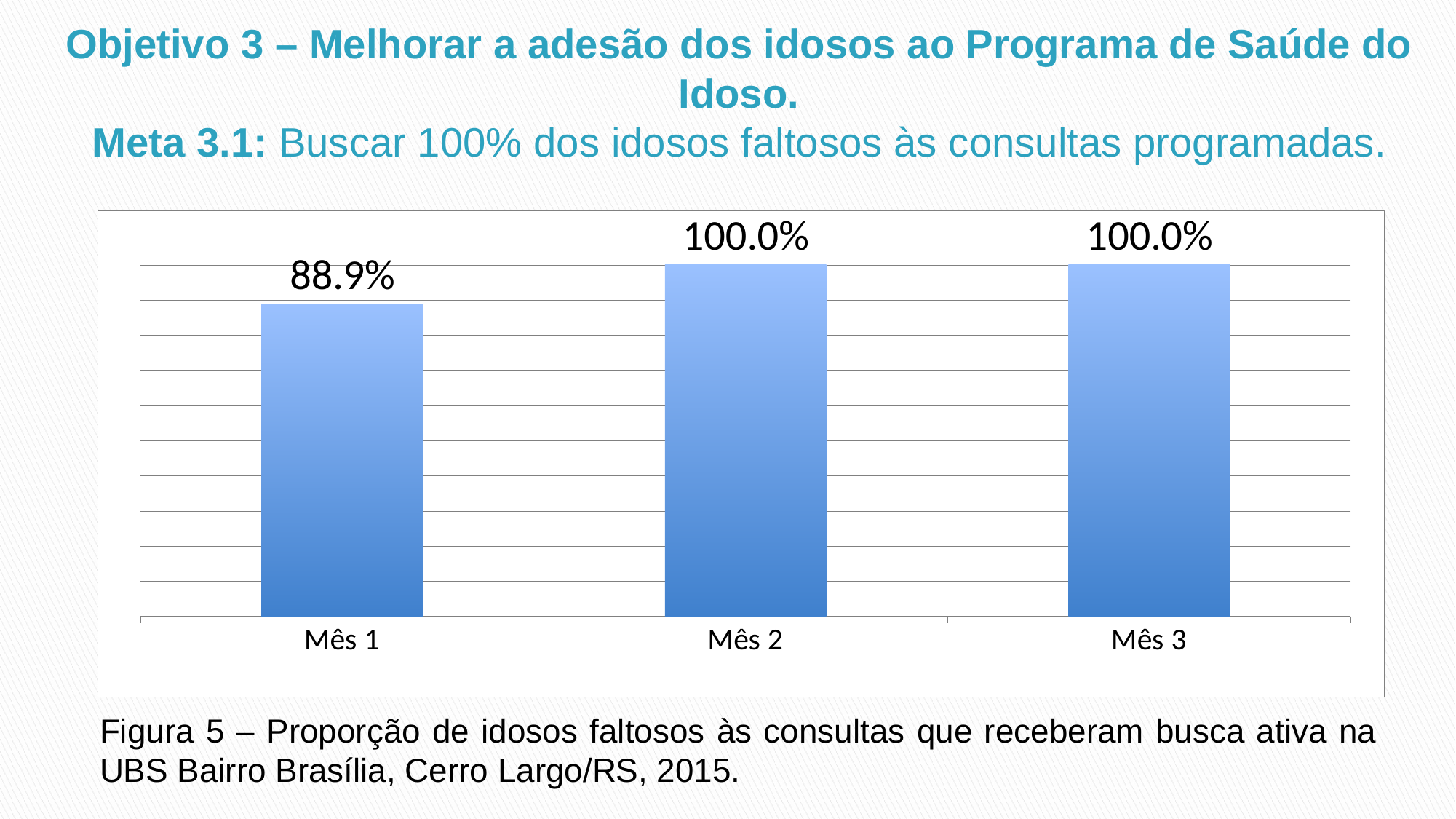
What is the value for Mês 3? 100.0% Do the values rise or fall from Mês 1 to Mês 2? Rise What is the figure number given in the caption below the chart? Figura 5 What colour are the bars in the chart? Blue What is the value for Mês 1? 88.9% How many categories are shown on the x axis? 3 What kind of chart is shown on the slide? Bar chart Which month has the lowest value? Mês 1 Does the value change between Mês 2 and Mês 3? No What is the difference between the values for Mês 2 and Mês 1? 11.1% What is the value for Mês 2? 100.0% Which is larger, the value for Mês 1 or the value for Mês 3? Mês 3